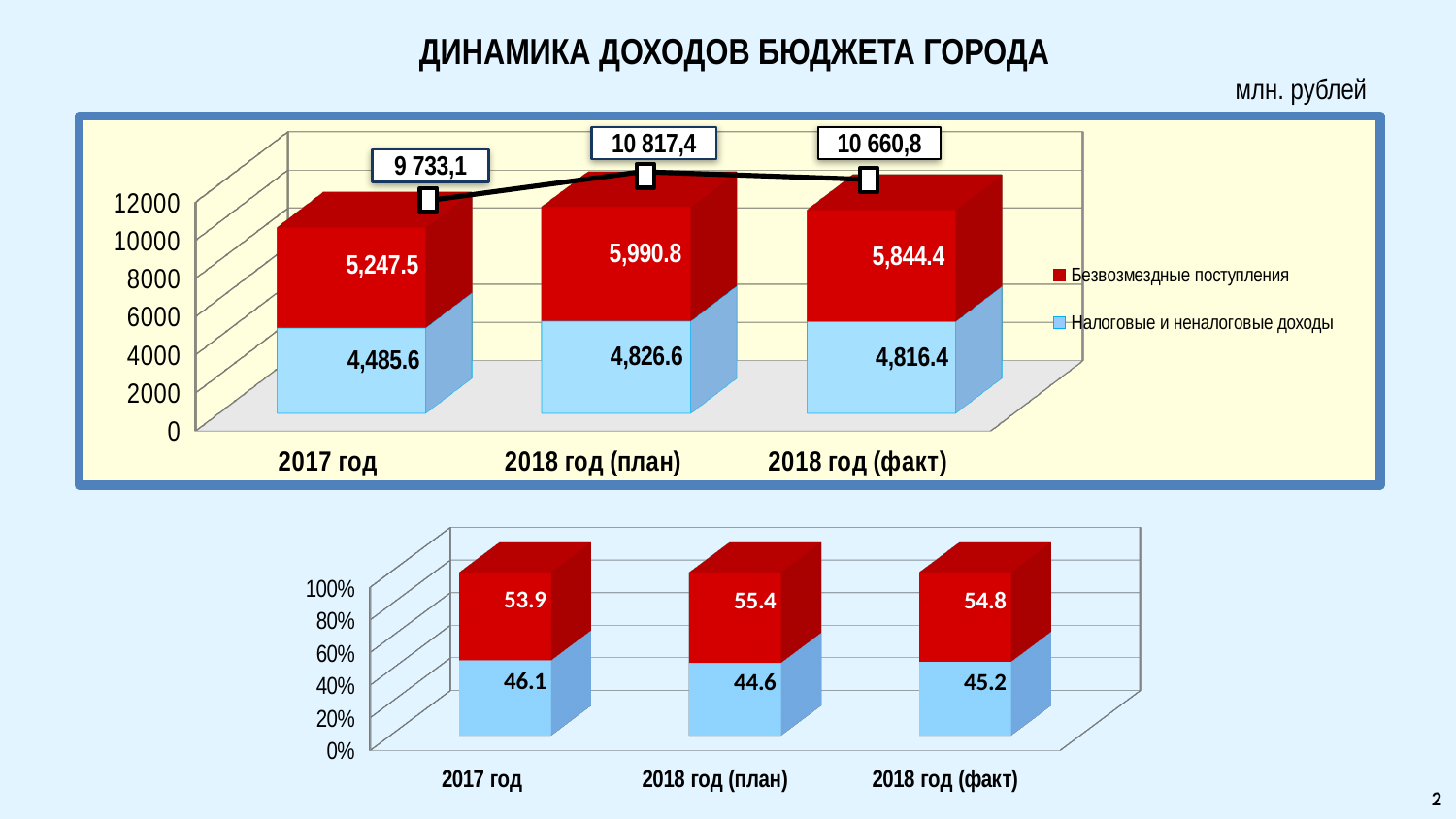
In the bottom chart, what is the value of the blue segment for 2018 год (факт)? 45.2 What kind of chart is the top chart? Stacked bar chart In the top chart, which category has the lowest value for Налоговые и неналоговые доходы? 2017 год In the bottom chart, what is the share of Безвозмездные поступления (red) for 2018 год (план)? 55.4 In the top chart, what is the value of Налоговые и неналоговые доходы for 2017 год? 4,485.6 In the top chart, which category has the highest total? 2018 год (план) In the top chart, what is the difference between Безвозмездные поступления for 2018 год (план) and 2018 год (факт)? 146.4 How many categories are shown on the x axis of the bottom chart? 3 In the top chart, what is the value of Безвозмездные поступления for 2018 год (план)? 5,990.8 In the top chart, what total is shown above the bar for 2018 год (факт)? 10 660,8 How many series does the legend of the top chart list? 2 In the top chart, is Безвозмездные поступления larger for 2017 год or for 2018 год (факт)? 2018 год (факт)